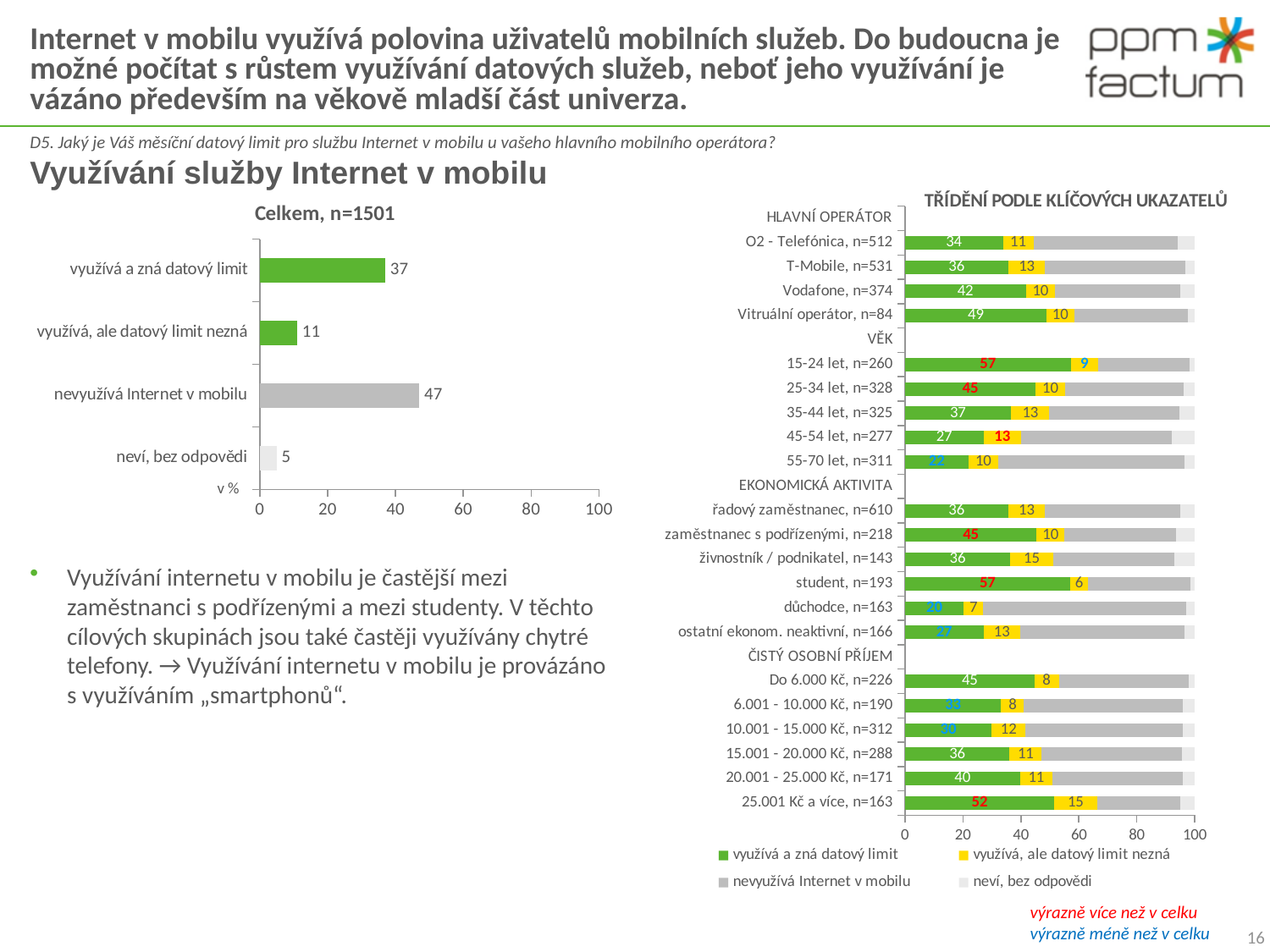
In the 'TŘÍDĚNÍ PODLE KLÍČOVÝCH UKAZATELŮ' chart, how many series does the legend list? 4 What kind of chart is the 'Celkem, n=1501' chart? bar chart In the 'TŘÍDĚNÍ PODLE KLÍČOVÝCH UKAZATELŮ' chart, among the age groups (VĚK), which has the lowest value for 'využívá a zná datový limit'? 55-70 let, n=311 In the 'Celkem, n=1501' chart, which category has the highest value? nevyužívá Internet v mobilu In the 'Celkem, n=1501' chart, what is the difference between 'nevyužívá Internet v mobilu' and 'využívá a zná datový limit'? 10 In the 'Celkem, n=1501' chart, which category has the lowest value? neví, bez odpovědi In the 'Celkem, n=1501' chart, how many categories are shown? 4 In the 'TŘÍDĚNÍ PODLE KLÍČOVÝCH UKAZATELŮ' chart, what is the value of 'využívá, ale datový limit nezná' for 'živnostník / podnikatel, n=143'? 15 In the 'TŘÍDĚNÍ PODLE KLÍČOVÝCH UKAZATELŮ' chart, what is the value of 'využívá a zná datový limit' for '15-24 let, n=260'? 57 In the 'TŘÍDĚNÍ PODLE KLÍČOVÝCH UKAZATELŮ' chart, which is larger for 'využívá a zná datový limit': 'Vodafone, n=374' or 'T-Mobile, n=531'? Vodafone, n=374 In the 'TŘÍDĚNÍ PODLE KLÍČOVÝCH UKAZATELŮ' chart, what colour represents 'využívá, ale datový limit nezná'? yellow In the 'Celkem, n=1501' chart, what is the value for 'využívá a zná datový limit'? 37